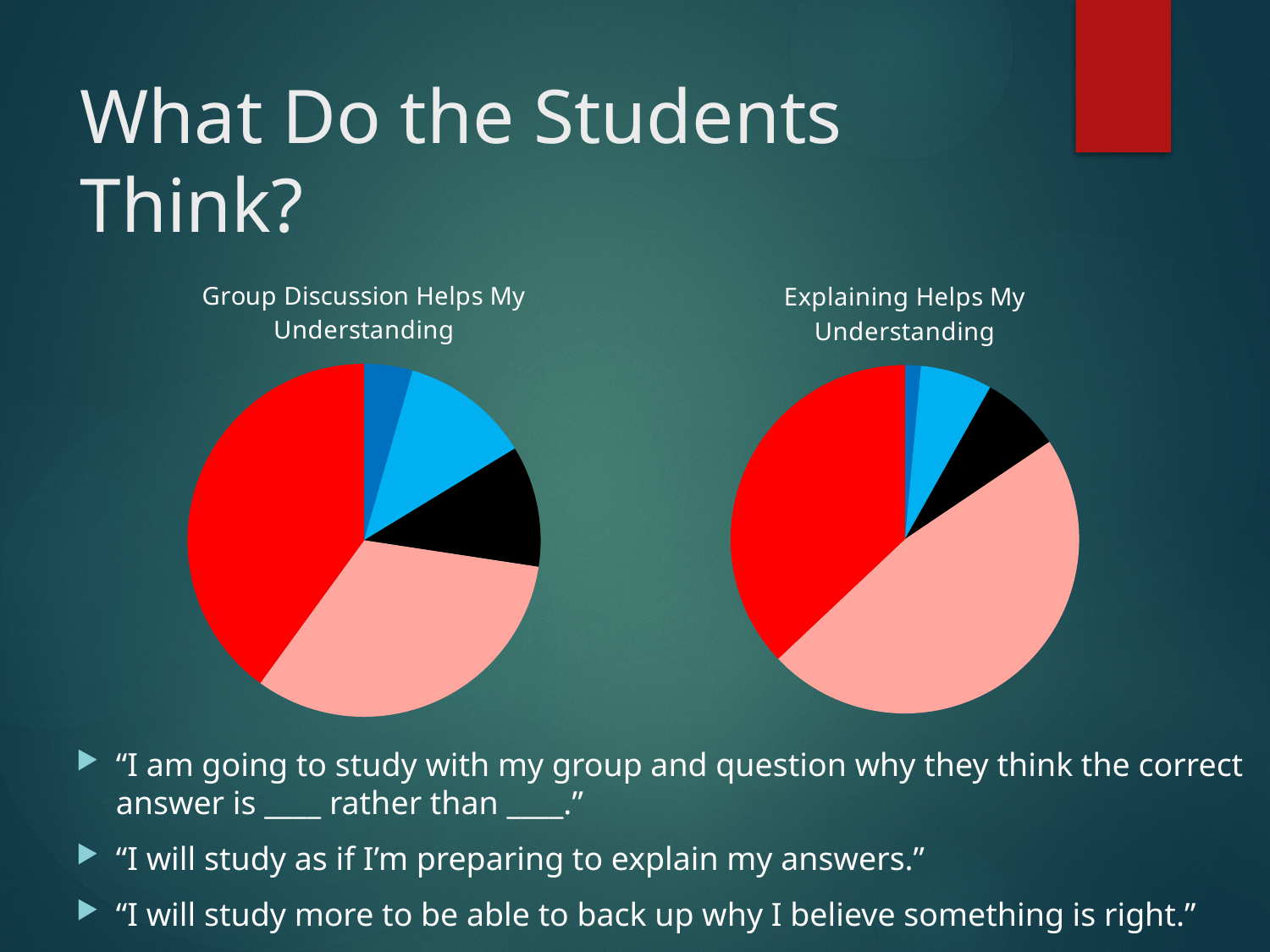
In the "Group Discussion Helps My Understanding" pie chart, which colour slice is the largest? red How many pie charts are shown on the slide? 2 What kind of chart is the "Group Discussion Helps My Understanding" chart? pie chart In the "Explaining Helps My Understanding" pie chart, which colour slice is the smallest? dark blue What kind of chart is the "Explaining Helps My Understanding" chart? pie chart In the "Explaining Helps My Understanding" pie chart, which colour slice is the largest? pink In the "Group Discussion Helps My Understanding" pie chart, which colour slice is the smallest? dark blue How many slices does the "Explaining Helps My Understanding" pie chart have? 5 What is the title of the pie chart on the left of the slide? Group Discussion Helps My Understanding How many slices does the "Group Discussion Helps My Understanding" pie chart have? 5